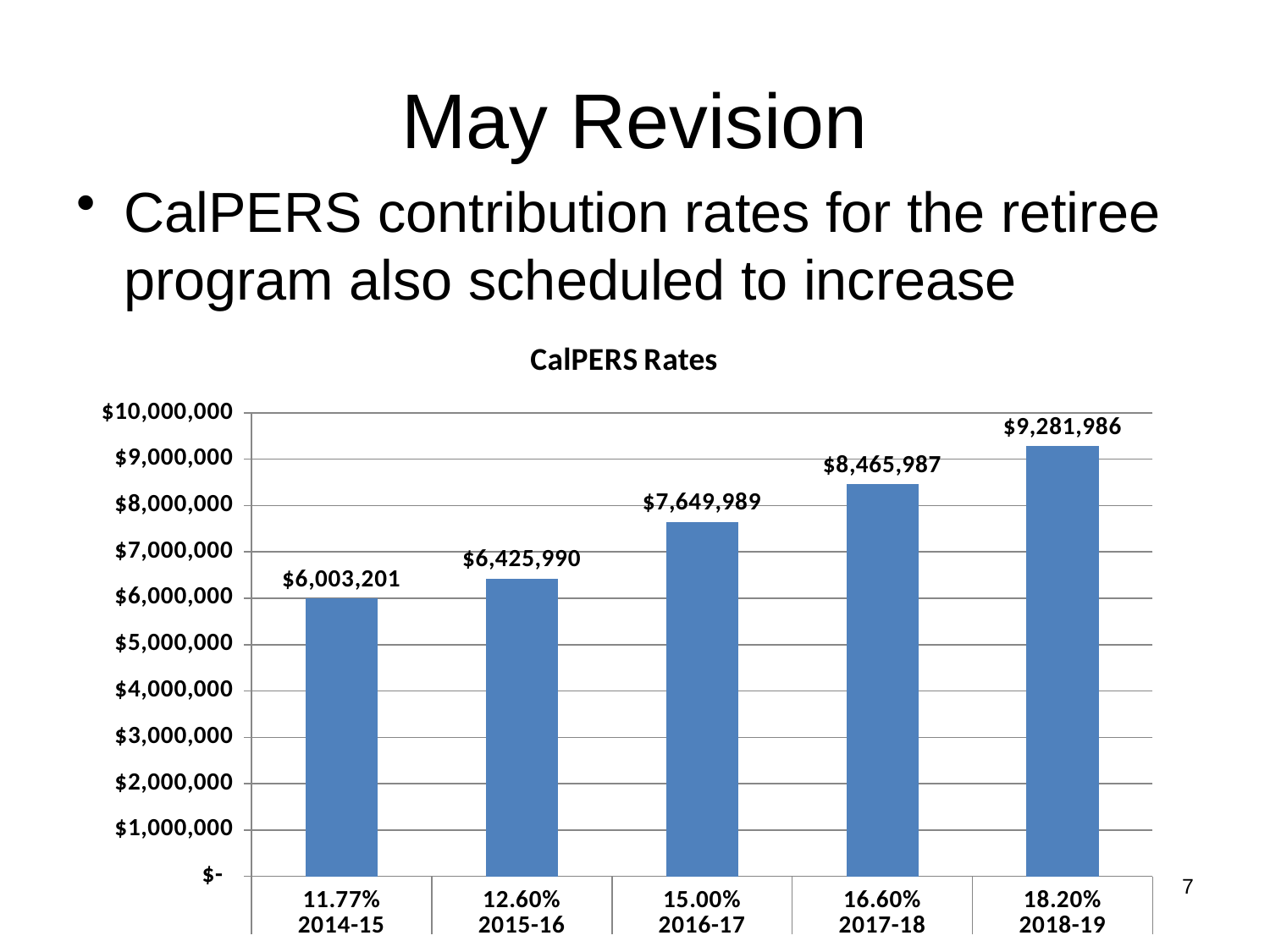
Do the CalPERS contribution amounts rise or fall from 2014-15 to 2018-19? rise What is the CalPERS contribution amount for 2014-15? $6,003,201 What is the CalPERS contribution amount for 2016-17? $7,649,989 Is the CalPERS contribution amount for 2017-18 greater or less than $8,000,000? greater What is the CalPERS contribution amount for 2018-19? $9,281,986 Which is larger, the CalPERS contribution amount for 2015-16 or for 2017-18? 2017-18 Which year has the highest CalPERS contribution amount? 2018-19 Which year has the lowest CalPERS contribution amount? 2014-15 How many years are shown in the CalPERS Rates chart? 5 What is the difference between the CalPERS contribution amounts for 2017-18 and 2016-17? $815,998 What is the difference between the CalPERS contribution amounts for 2018-19 and 2014-15? $3,278,785 What kind of chart is the CalPERS Rates chart? bar chart